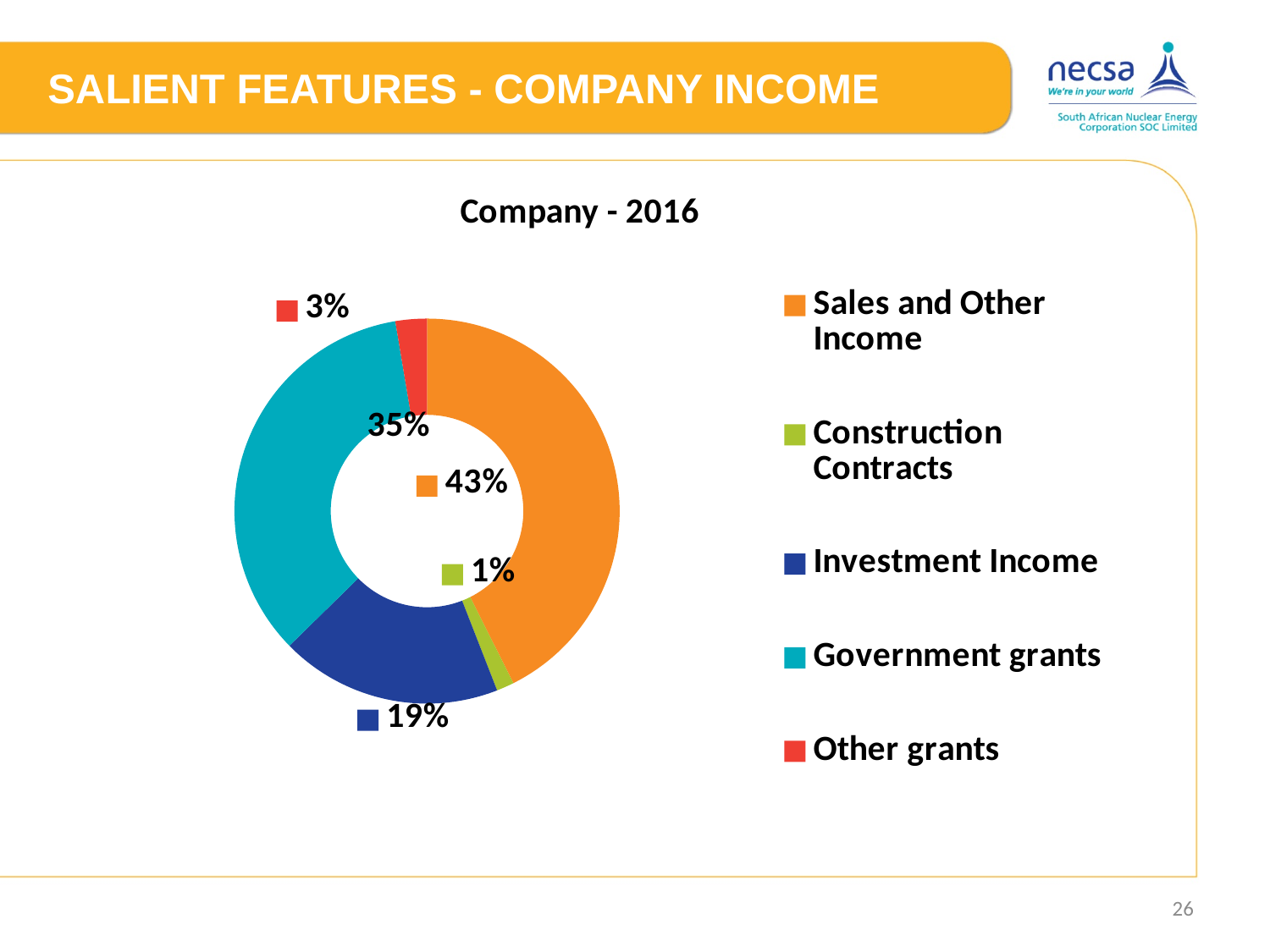
What type of chart is shown on the slide? Doughnut (pie) chart What percentage of the chart is Government grants? 35% What is the value for Other grants? 3% Which is larger, Investment Income or Other grants? Investment Income What is the difference in percentage points between Sales and Other Income and Government grants? 8% Which category has the smallest share? Construction Contracts What share of company income in 2016 comes from Sales and Other Income? 43% What percentage does Construction Contracts contribute? 1% How many categories are shown in the chart? 5 What is the value shown for Investment Income? 19% What is the title of the chart? Company - 2016 Which category has the largest share of company income? Sales and Other Income